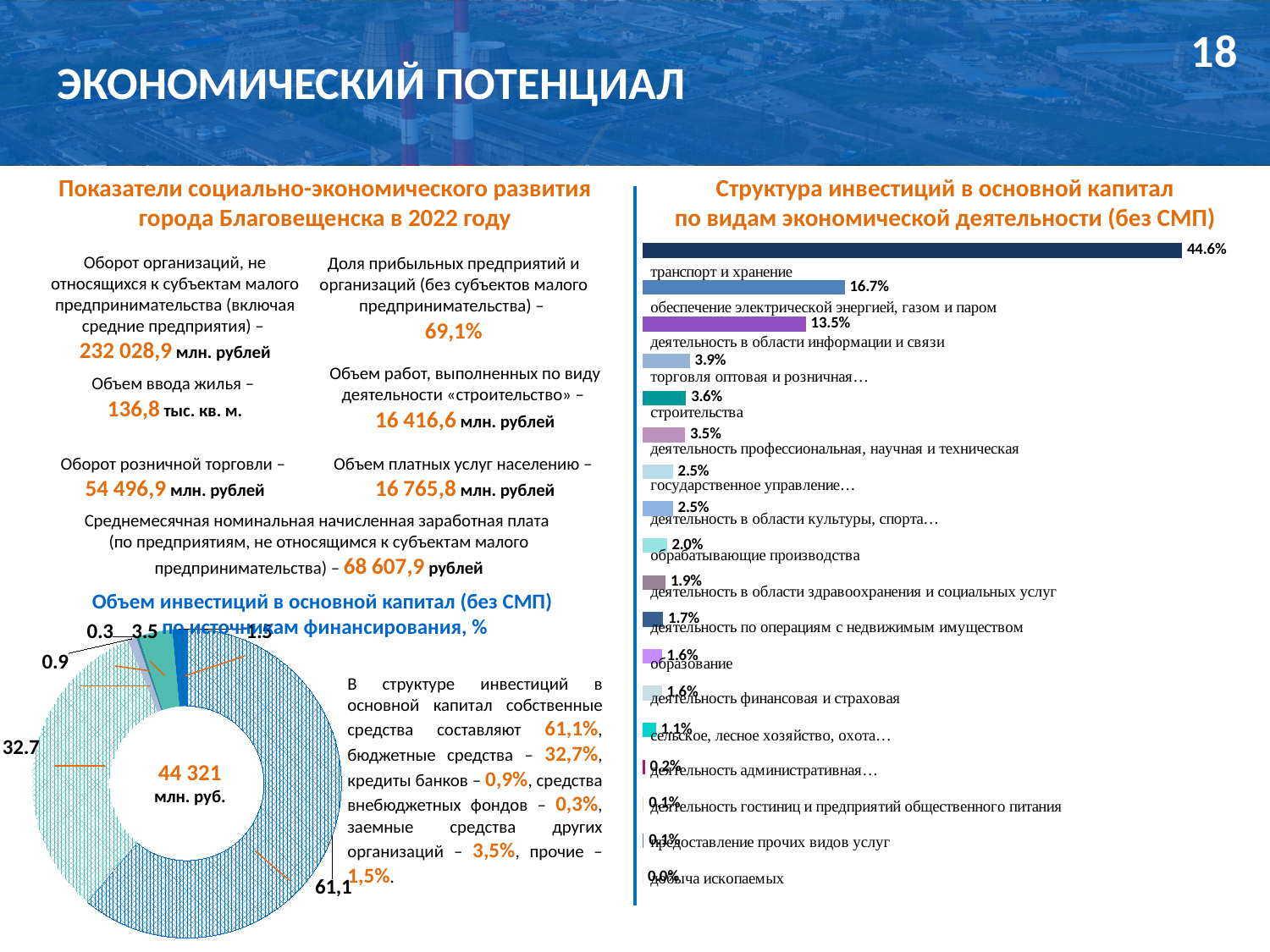
What type of chart is 'Структура инвестиций в основной капитал по видам экономической деятельности (без СМП)'? bar chart In the bar chart 'Структура инвестиций в основной капитал по видам экономической деятельности (без СМП)', which category has the highest value? транспорт и хранение How many slices does the doughnut chart 'Объем инвестиций в основной капитал (без СМП) по источникам финансирования, %' have? 6 In the bar chart 'Структура инвестиций в основной капитал по видам экономической деятельности (без СМП)', what is the value for 'транспорт и хранение'? 44.6% What value is printed in the centre of the doughnut chart 'Объем инвестиций в основной капитал (без СМП) по источникам финансирования, %'? 44 321 млн. руб. How many categories are shown in the bar chart 'Структура инвестиций в основной капитал по видам экономической деятельности (без СМП)'? 18 In the bar chart 'Структура инвестиций в основной капитал по видам экономической деятельности (без СМП)', which is larger: 'торговля оптовая и розничная…' or 'строительства'? торговля оптовая и розничная… In the bar chart 'Структура инвестиций в основной капитал по видам экономической деятельности (без СМП)', what is the value for 'деятельность в области информации и связи'? 13.5% In the doughnut chart 'Объем инвестиций в основной капитал (без СМП) по источникам финансирования, %', what is the largest slice value? 61,1 In the bar chart 'Структура инвестиций в основной капитал по видам экономической деятельности (без СМП)', which category has the lowest value? добыча ископаемых In the bar chart 'Структура инвестиций в основной капитал по видам экономической деятельности (без СМП)', what is the difference between 'транспорт и хранение' and 'обеспечение электрической энергией, газом и паром'? 27.9% What type of chart is 'Объем инвестиций в основной капитал (без СМП) по источникам финансирования, %'? doughnut chart